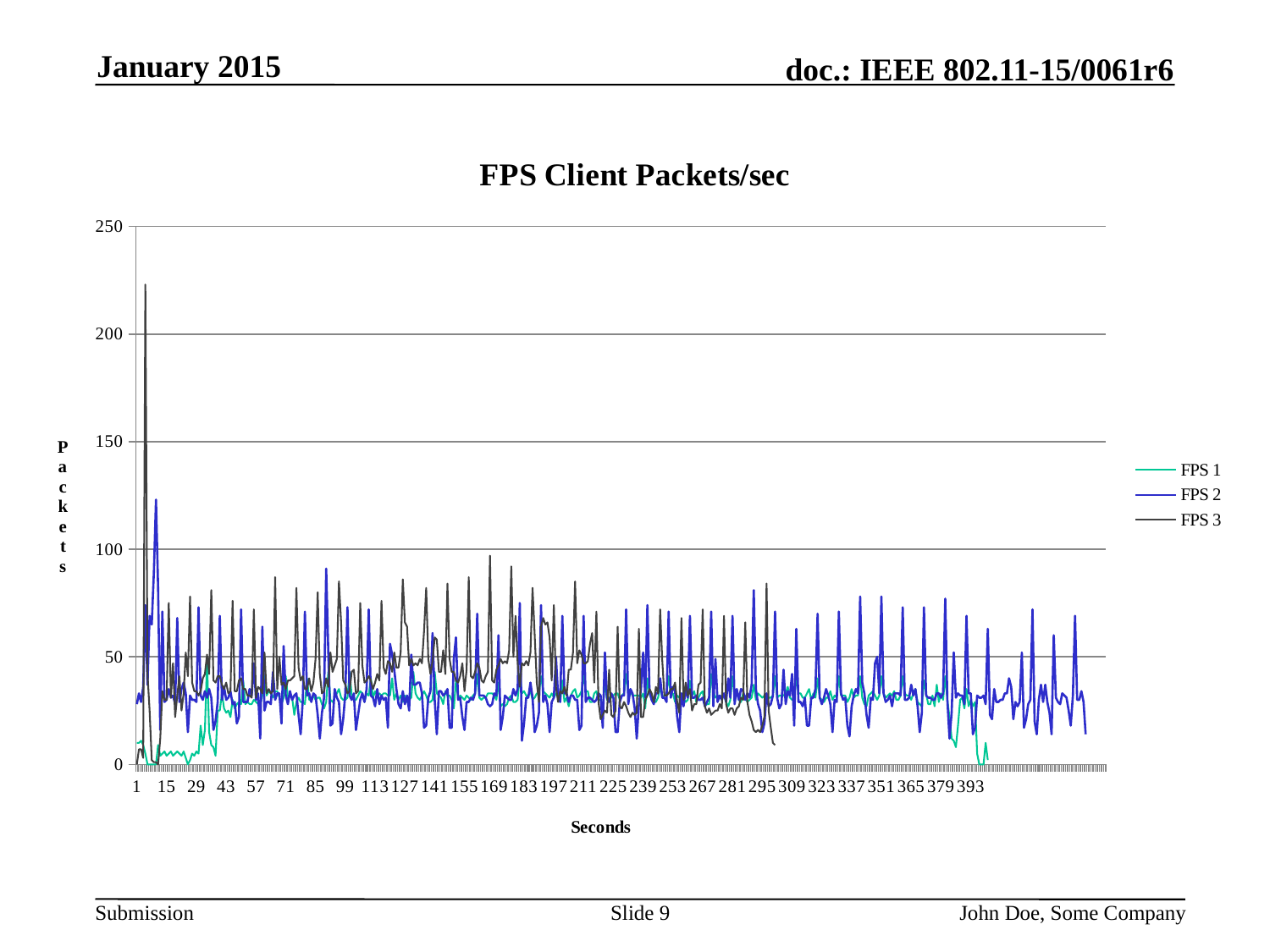
Which series has the lowest peak value on the chart? FPS 1 Is the highest value reached by FPS 3 greater or less than 200? greater Which series has a higher peak value, FPS 2 or FPS 1? FPS 2 What kind of chart is shown on the slide? line chart Which series reaches the highest peak value on the chart? FPS 3 What is the title of the chart? FPS Client Packets/sec How many series does the legend list? 3 What are the names of the series listed in the legend? FPS 1, FPS 2, FPS 3 What is the highest value shown on the vertical axis? 250 Is the highest value reached by FPS 1 greater or less than 100? less What is the first value shown on the horizontal axis? 1 Is the highest value reached by FPS 2 greater or less than 150? less